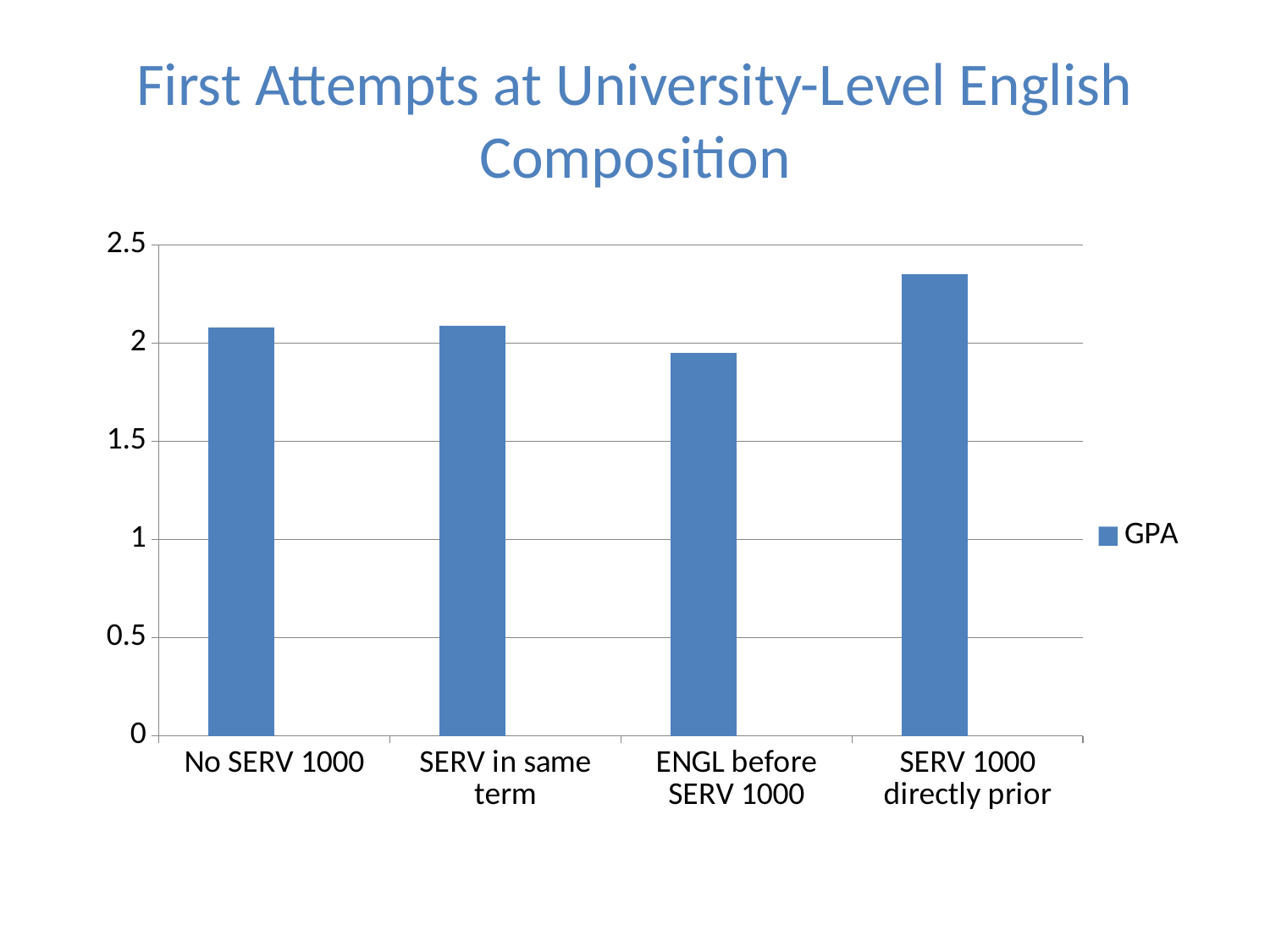
Is the GPA for No SERV 1000 greater or less than 1.5? greater Is the GPA for SERV 1000 directly prior greater or less than 2.5? less How many categories are shown on the x axis of the chart? 4 What kind of chart is shown on the slide? bar chart How many series does the legend list? 1 Which category has the lowest GPA? ENGL before SERV 1000 Is the GPA for ENGL before SERV 1000 greater or less than 2? less What series name appears in the legend? GPA What is the title of the chart? First Attempts at University-Level English Composition Which category has the highest GPA? SERV 1000 directly prior Which has the larger GPA, SERV 1000 directly prior or ENGL before SERV 1000? SERV 1000 directly prior